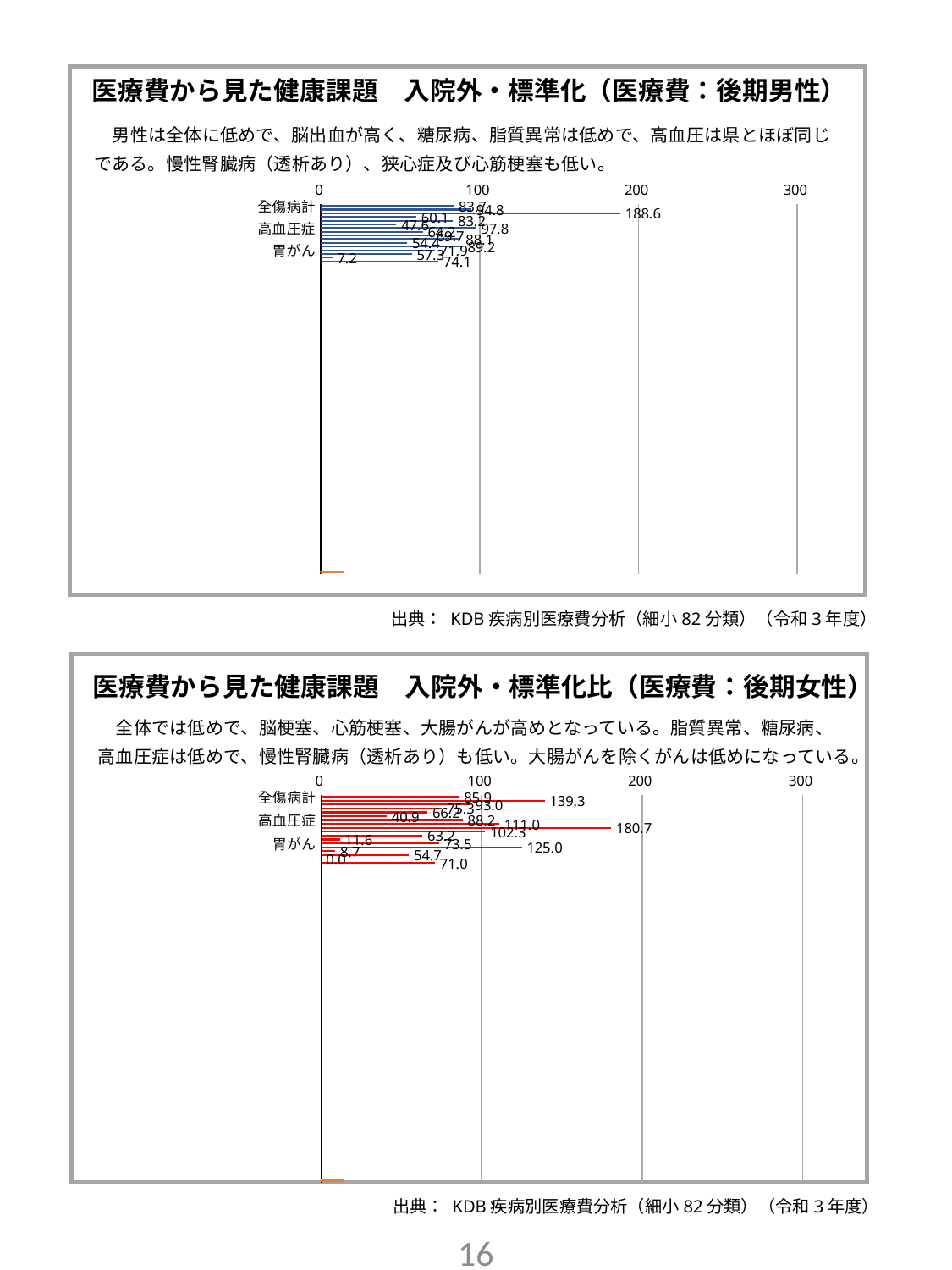
Which chart has the larger maximum value, the top chart (後期男性) with 188.6 or the bottom chart (後期女性) with 180.7? top chart (後期男性) In the top chart (後期男性), what is the value of the longest bar? 188.6 What is the title of the bottom chart? 医療費から見た健康課題 入院外・標準化比（医療費：後期女性） In the top chart (後期男性), is the longest bar greater or less than 100? greater What is the difference between the largest value in the top chart (188.6) and the largest value in the bottom chart (180.7)? 7.9 What type of chart is shown on the top chart (後期男性)? bar chart What type of chart is shown on the bottom chart (後期女性)? bar chart In the top chart (後期男性), what is the value of the shortest bar? 7.2 What is the highest tick value shown on the x axis of the top chart (後期男性)? 300 In the bottom chart (後期女性), is the bar labelled 40.9 greater or less than 100? less In the bottom chart (後期女性), what is the value of the shortest bar? 0.0 In the bottom chart (後期女性), what is the value of the longest bar? 180.7